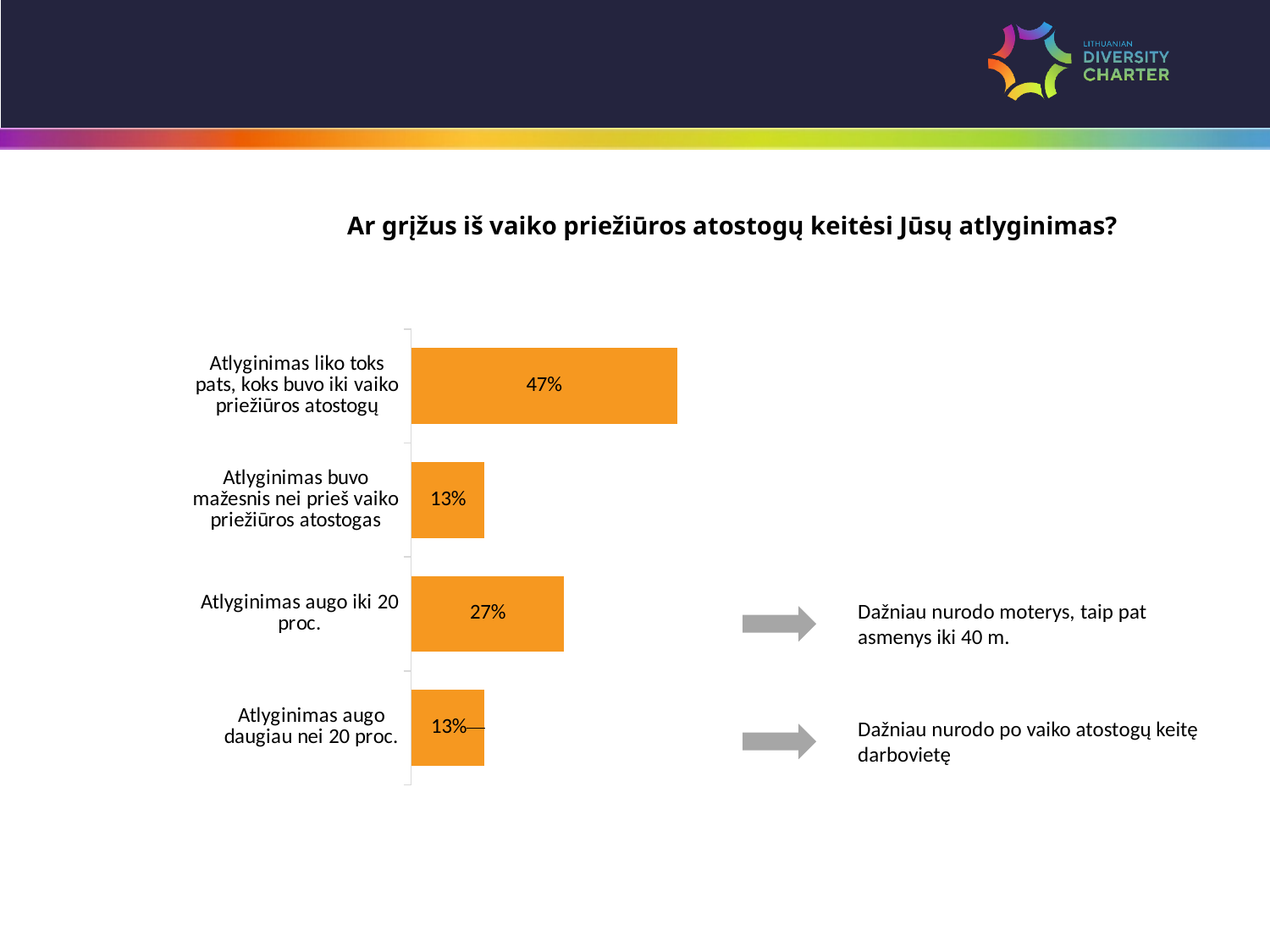
What percentage is shown for "Atlyginimas liko toks pats, koks buvo iki vaiko priežiūros atostogų"? 47% Which category has the highest value? Atlyginimas liko toks pats, koks buvo iki vaiko priežiūros atostogų What percentage is shown for "Atlyginimas buvo mažesnis nei prieš vaiko priežiūros atostogas"? 13% What percentage is shown for "Atlyginimas augo iki 20 proc."? 27% What colour are the bars in the chart? Orange What kind of chart is shown on the slide? Bar chart What is the difference between the values for "Atlyginimas liko toks pats, koks buvo iki vaiko priežiūros atostogų" and "Atlyginimas augo iki 20 proc."? 20% What is the difference between the values for "Atlyginimas augo iki 20 proc." and "Atlyginimas augo daugiau nei 20 proc."? 14% What percentage is shown for "Atlyginimas augo daugiau nei 20 proc."? 13% How many categories does the chart show? 4 What is the title of the chart? Ar grįžus iš vaiko priežiūros atostogų keitėsi Jūsų atlyginimas? Which is larger: the value for "Atlyginimas augo iki 20 proc." or for "Atlyginimas buvo mažesnis nei prieš vaiko priežiūros atostogas"? Atlyginimas augo iki 20 proc.